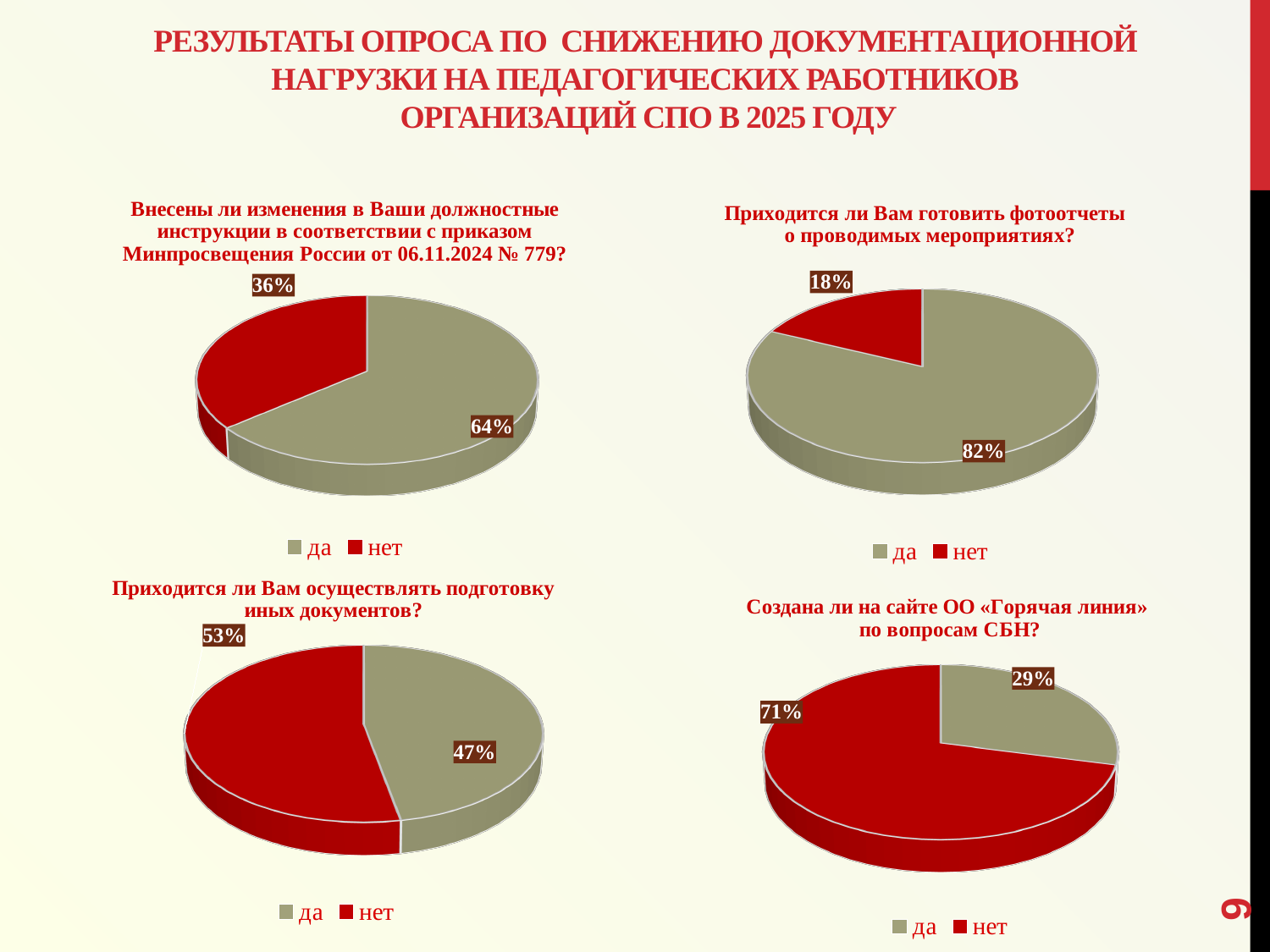
In the top-right chart (Приходится ли Вам готовить фотоотчеты о проводимых мероприятиях?), what share of the pie is «да»? 82% In the bottom-left chart (Приходится ли Вам осуществлять подготовку иных документов?), what percentage answered «нет»? 53% In the bottom-right chart (Создана ли на сайте ОО «Горячая линия» по вопросам СБН?), what is the difference between the «нет» and «да» shares? 42 percentage points In the top-right chart (Приходится ли Вам готовить фотоотчеты о проводимых мероприятиях?), what is the value for «нет»? 18% In the top-left chart (Внесены ли изменения в Ваши должностные инструкции...), what is the difference between the «да» and «нет» shares? 28 percentage points In the bottom-right chart (Создана ли на сайте ОО «Горячая линия» по вопросам СБН?), which colour represents «нет»? Red In the top-left chart (Внесены ли изменения в Ваши должностные инструкции...), what percentage answered «нет»? 36% In the top-left chart (Внесены ли изменения в Ваши должностные инструкции...), what percentage answered «да»? 64% How many categories does the legend of the bottom-left chart (Приходится ли Вам осуществлять подготовку иных документов?) list? 2 What type of chart is used for the top-right chart (Приходится ли Вам готовить фотоотчеты о проводимых мероприятиях?)? Pie chart In the bottom-left chart (Приходится ли Вам осуществлять подготовку иных документов?), which answer has the larger share, «да» or «нет»? нет In the bottom-right chart (Создана ли на сайте ОО «Горячая линия» по вопросам СБН?), what percentage answered «да»? 29%